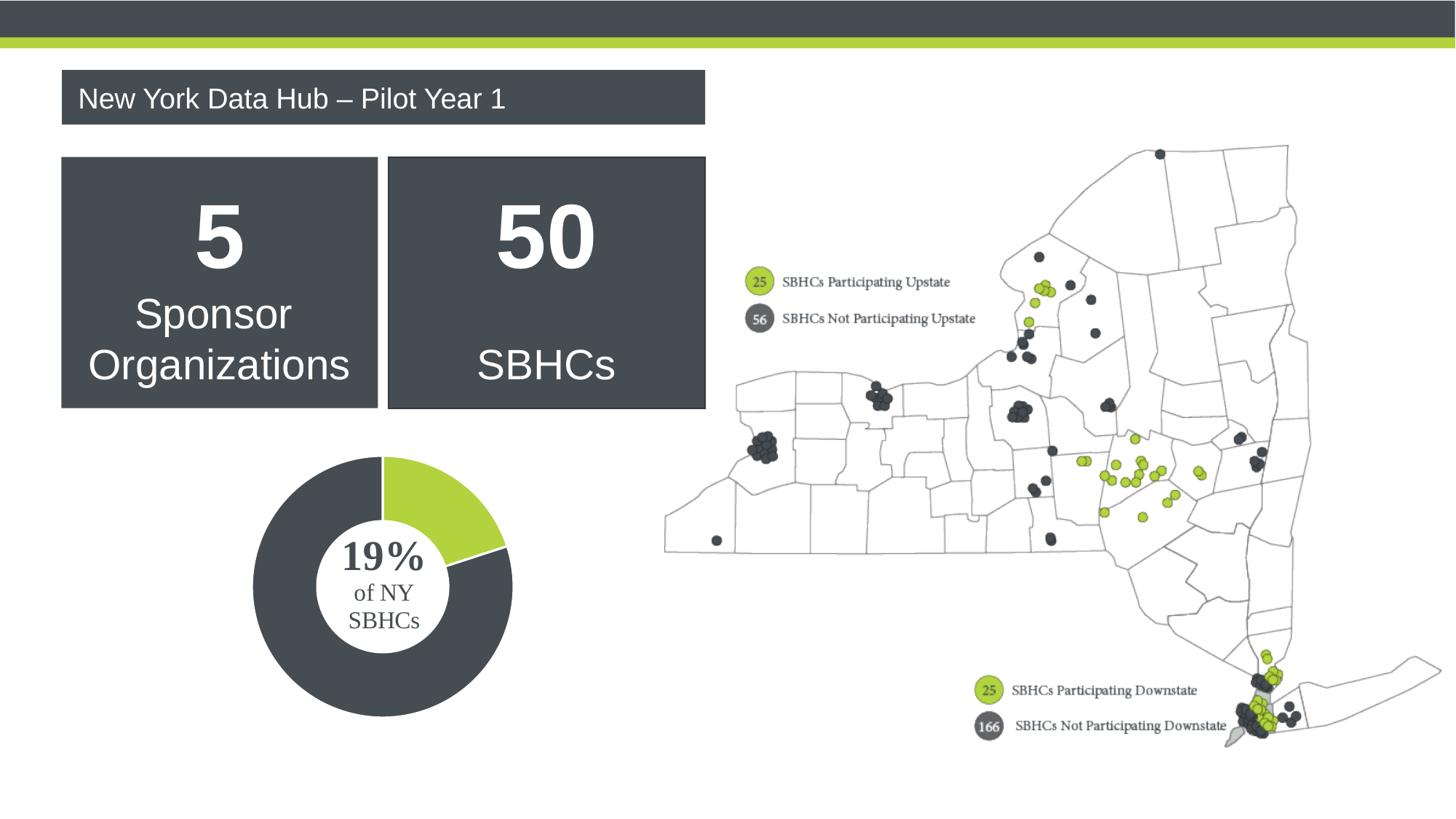
In the donut chart, which slice is larger, the green slice or the dark grey slice? The dark grey slice On the map, how many SBHCs are participating upstate according to the legend? 25 On the map legend, which category has the highest count? SBHCs Not Participating Downstate On the map, what is the total number of participating SBHCs (upstate plus downstate)? 50 On the map, what colour marks the SBHCs that are participating? Green What kind of chart is shown in the lower left of the slide? Donut (pie) chart In the donut chart, what share of NY SBHCs does the green slice represent? 19% How many slices does the donut chart have? 2 On the map, how many SBHCs are not participating downstate according to the legend? 166 On the map, what is the difference between the number of SBHCs not participating downstate and the number not participating upstate? 110 On the map, how many SBHCs are not participating upstate according to the legend? 56 Is the green slice of the donut chart greater or less than 25% of the whole? less